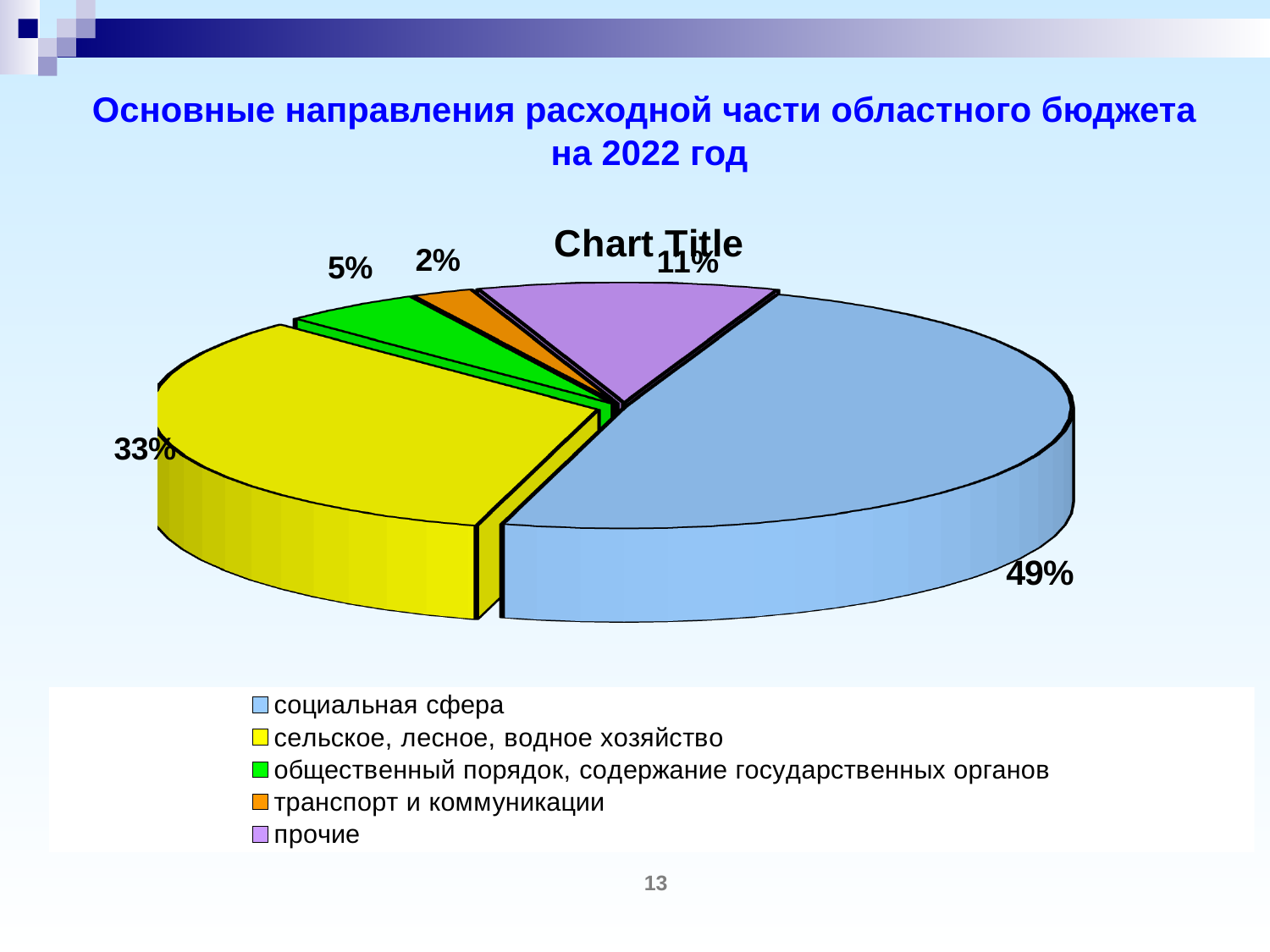
What share of the pie does "общественный порядок, содержание государственных органов" have? 5% What share of the pie does "социальная сфера" have? 49% How many categories does the legend list? 5 What share of the pie does "прочие" have? 11% Which category has the smallest slice of the pie? транспорт и коммуникации What kind of chart is shown on the slide? pie chart Which category has the largest slice of the pie? социальная сфера What colour is the slice for "сельское, лесное, водное хозяйство"? yellow What is the difference between the shares of "социальная сфера" and "сельское, лесное, водное хозяйство"? 16% Which is larger, the share of "прочие" or the share of "общественный порядок, содержание государственных органов"? прочие